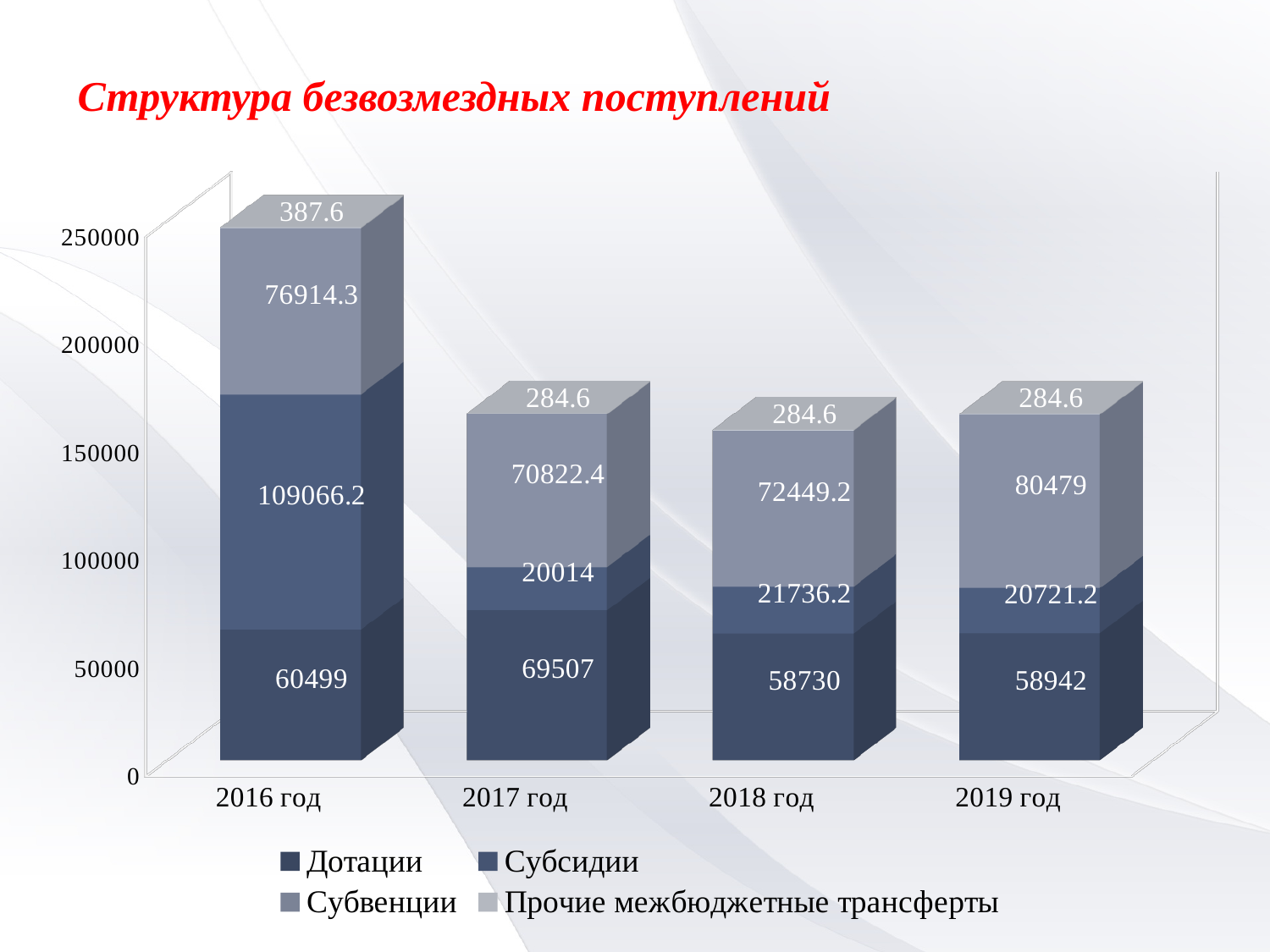
Which is larger: Субвенции for 2018 год or Субвенции for 2019 год? Субвенции for 2019 год In which year is the Дотации value highest? 2017 год In which year is the Субсидии value lowest? 2017 год What kind of chart is shown on the slide? Stacked bar chart What is the total of the stacked bar for 2017 год? 160628 What is the difference between the Субсидии values for 2016 год and 2017 год? 89052.2 What is the value of Субсидии for 2016 год? 109066.2 What is the difference between the Дотации values for 2017 год and 2016 год? 9008 How many series does the legend list? 4 What is the value of Дотации for 2018 год? 58730 What is the value of Прочие межбюджетные трансферты for 2016 год? 387.6 What is the value of Субвенции for 2019 год? 80479